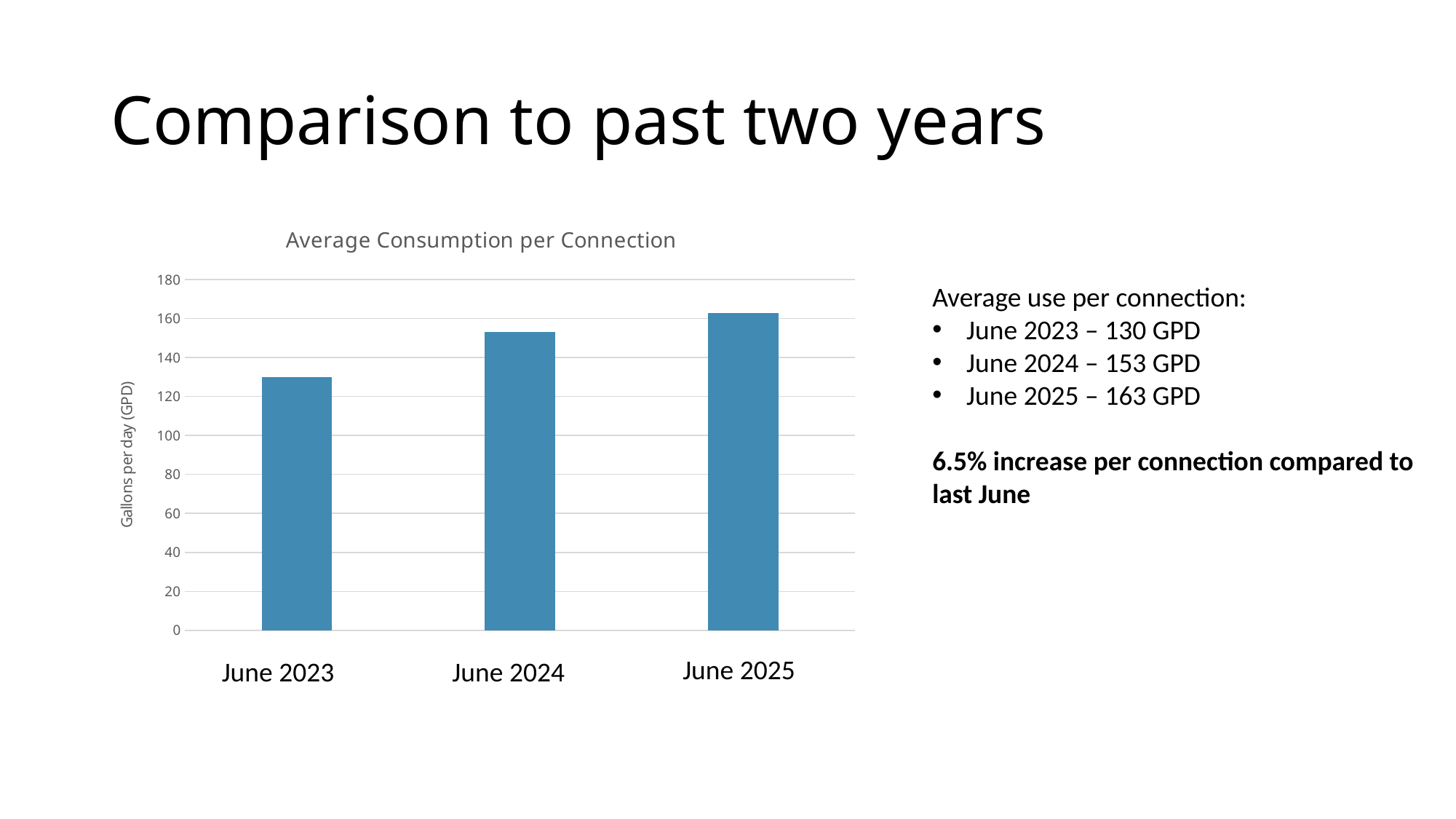
Which month has the highest average consumption per connection? June 2025 How many bars are plotted in the chart? 3 What is the average consumption per connection for June 2024? 153 GPD What is the label of the vertical axis of the chart? Gallons per day (GPD) Is the value for June 2023 greater or less than 140? less What kind of chart is shown on the slide? bar chart What is the average consumption per connection for June 2023? 130 GPD What is the difference in average consumption per connection between June 2025 and June 2024? 10 GPD Do the values rise or fall from June 2023 to June 2025? rise Which month has the lowest average consumption per connection? June 2023 What is the title of the chart? Average Consumption per Connection What is the average consumption per connection for June 2025? 163 GPD